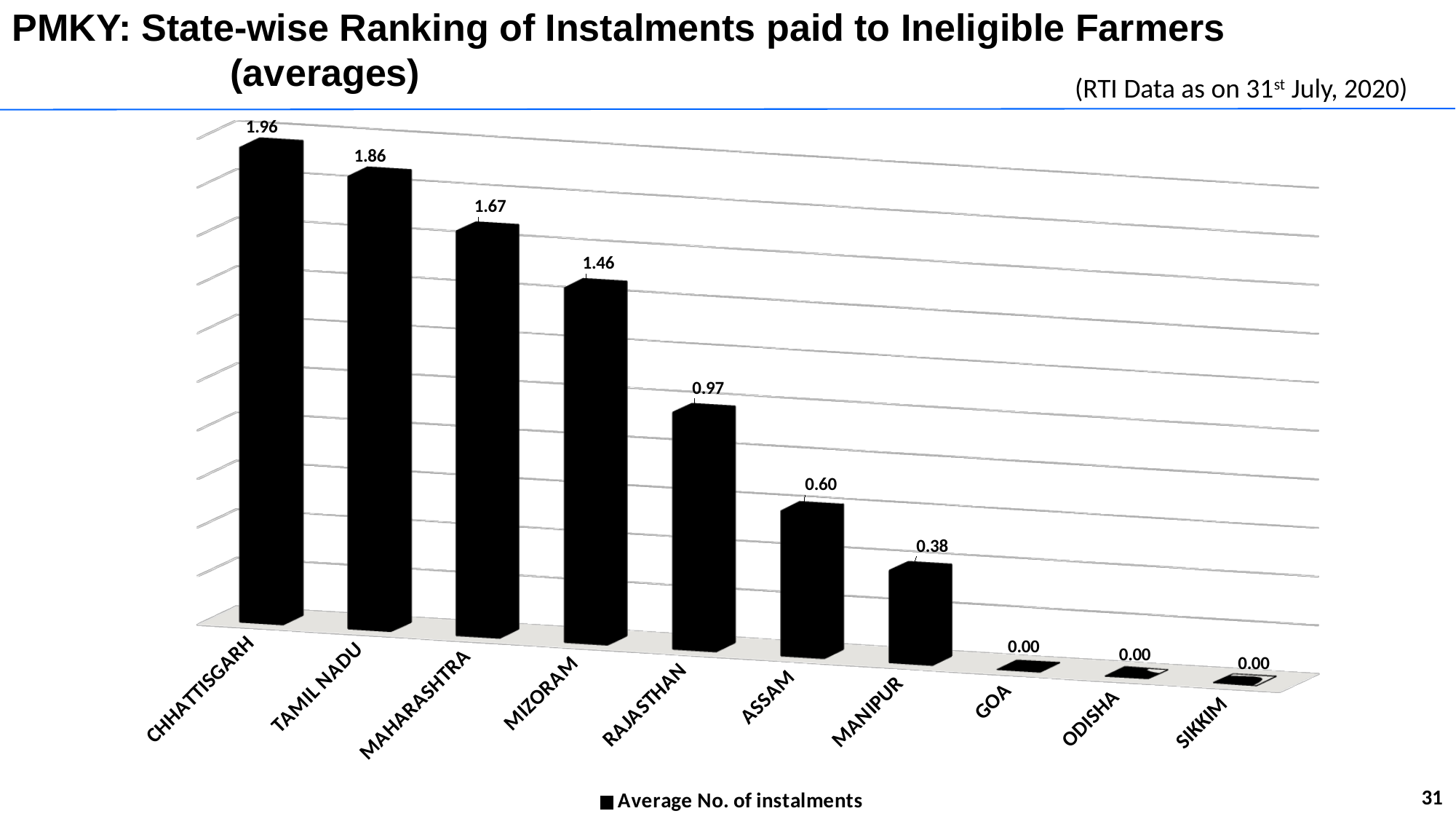
Which is larger, the value for Maharashtra or the value for Rajasthan? Maharashtra How many states have a value of 0.00? 3 What is the difference between the values for Tamil Nadu and Maharashtra? 0.19 Which state has the highest average number of instalments? Chhattisgarh What is the average number of instalments for Chhattisgarh? 1.96 What is the difference between the values for Mizoram and Assam? 0.86 Do the values rise or fall from left to right along the x axis? Fall What is the average number of instalments for Manipur? 0.38 How many states are shown on the chart? 10 What is the average number of instalments for Rajasthan? 0.97 What kind of chart is shown on the slide? Bar chart How many series does the legend list? 1